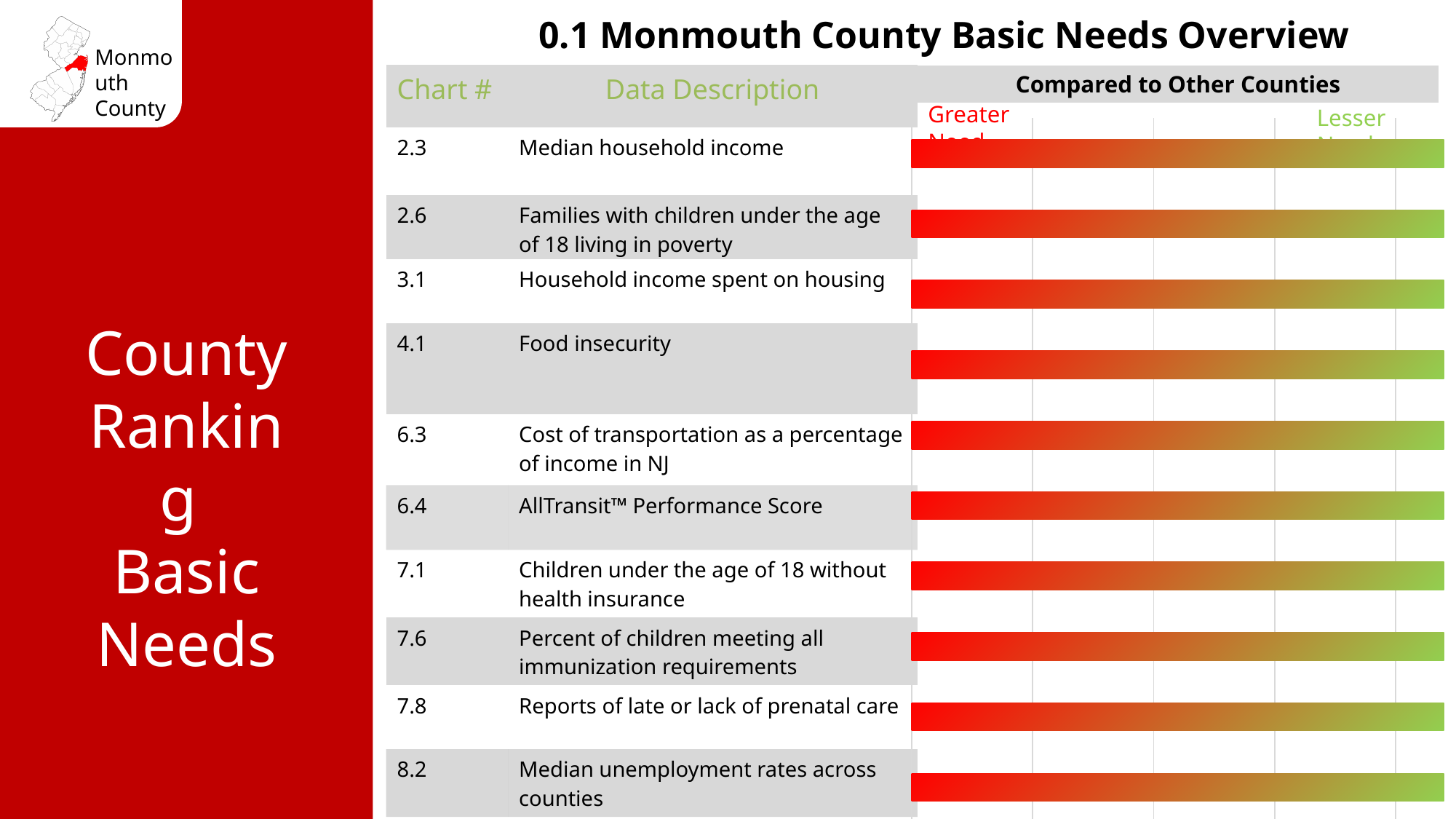
What kind of chart is shown on the slide? bar chart How many data description rows (bars) are shown in the chart? 10 What is the title of the chart on the slide? 0.1 Monmouth County Basic Needs Overview Which chart number corresponds to the data description "Food insecurity"? 4.1 What data description is listed for chart number 6.4? AllTransit™ Performance Score Which chart number corresponds to "Reports of late or lack of prenatal care"? 7.8 Which chart number corresponds to "Median household income"? 2.3 What label appears at the left (red) end of the bars? Greater Need What data description is listed for chart number 8.2? Median unemployment rates across counties